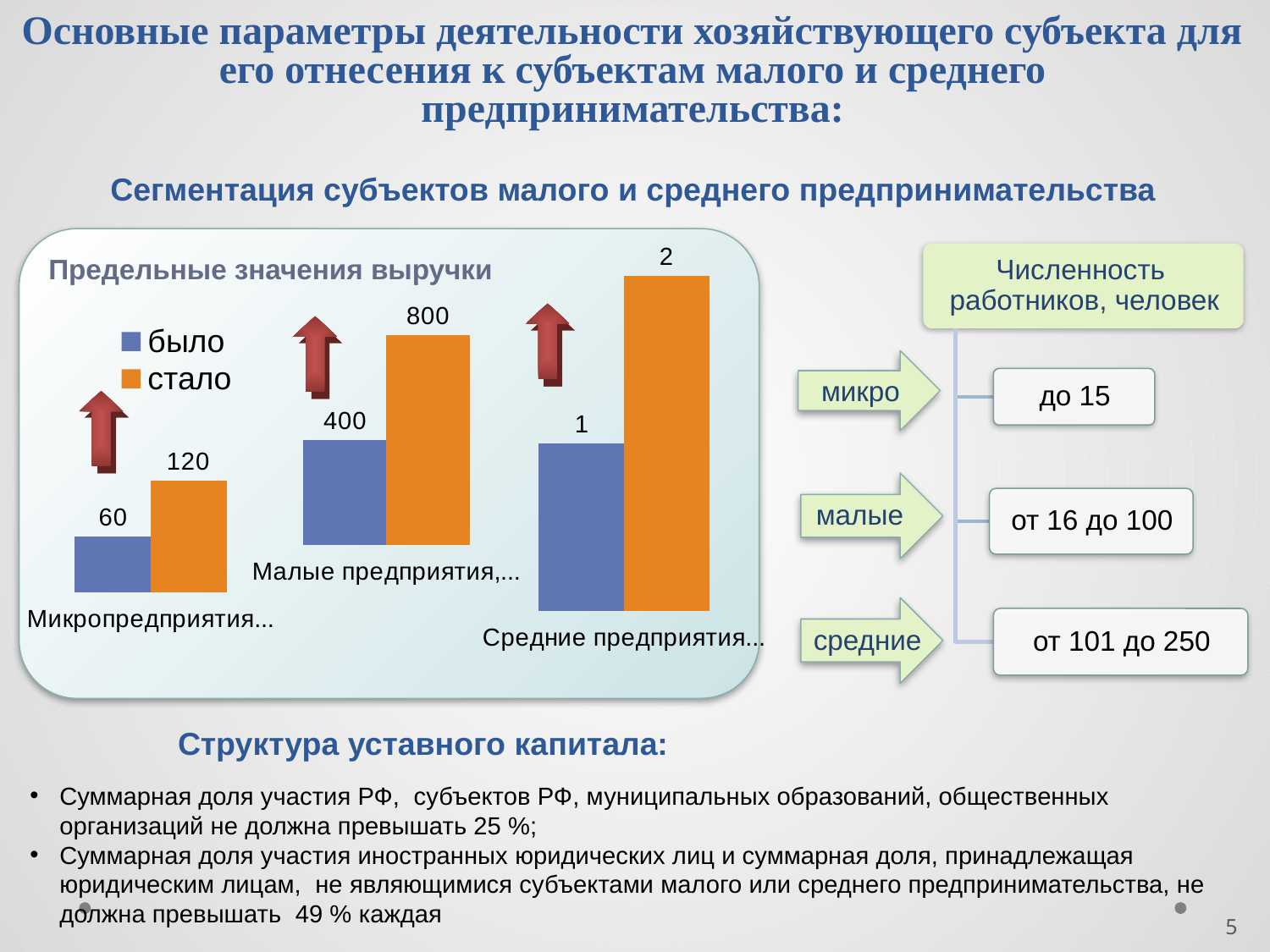
What is the value of the 'стало' series for Микропредприятия in the 'Предельные значения выручки' chart? 120 What type of chart is 'Предельные значения выручки'? Bar chart In the 'Предельные значения выручки' chart, which is larger for Микропредприятия: the 'было' value or the 'стало' value? стало What is the value of the 'было' series for Малые предприятия in the 'Предельные значения выручки' chart? 400 How many series does the legend of the 'Предельные значения выручки' chart list? 2 What is the value of the 'было' series for Средние предприятия in the 'Предельные значения выручки' chart? 1 In the 'Предельные значения выручки' chart, what is the difference between the 'стало' and 'было' values for Малые предприятия? 400 How many categories are shown in the 'Предельные значения выручки' chart? 3 What is the value of the 'было' series for Микропредприятия in the 'Предельные значения выручки' chart? 60 In the 'Предельные значения выручки' chart, what is the difference between the 'стало' and 'было' values for Микропредприятия? 60 What is the value of the 'стало' series for Средние предприятия in the 'Предельные значения выручки' chart? 2 What is the value of the 'стало' series for Малые предприятия in the 'Предельные значения выручки' chart? 800